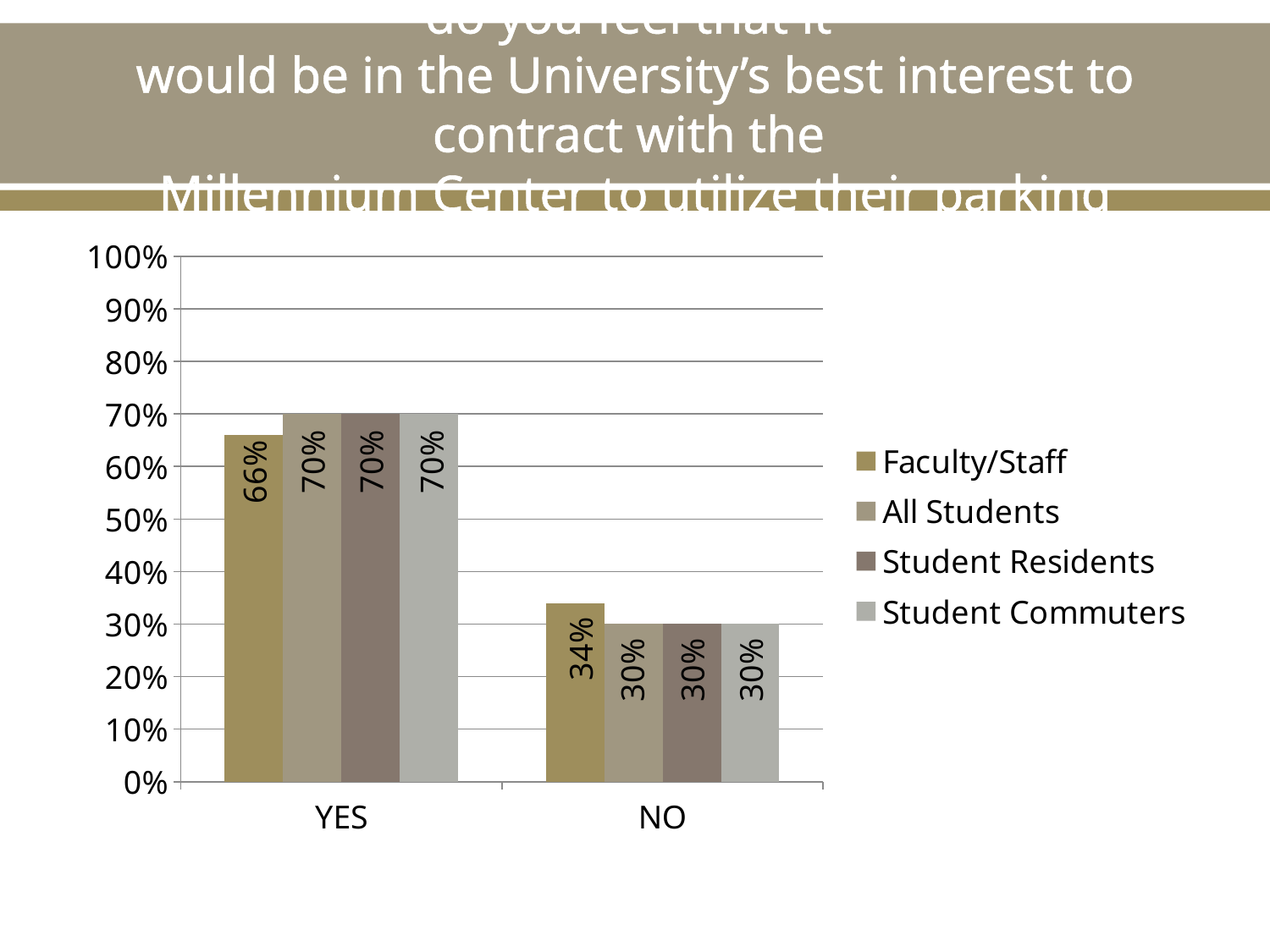
Which group has the highest percentage for NO? Faculty/Staff What is the difference between the YES and NO percentages for Faculty/Staff? 32% How many categories are shown on the x axis? 2 What percentage of Faculty/Staff answered YES? 66% How many series does the legend list? 4 What is the difference between the YES percentages for Student Residents and Faculty/Staff? 4% What kind of chart is shown on the slide? Bar chart What percentage of Student Commuters answered NO? 30% Which group has the lowest percentage for YES? Faculty/Staff Which is larger: the YES percentage for Faculty/Staff or the YES percentage for Student Residents? Student Residents What percentage of All Students answered YES? 70% What percentage of Faculty/Staff answered NO? 34%